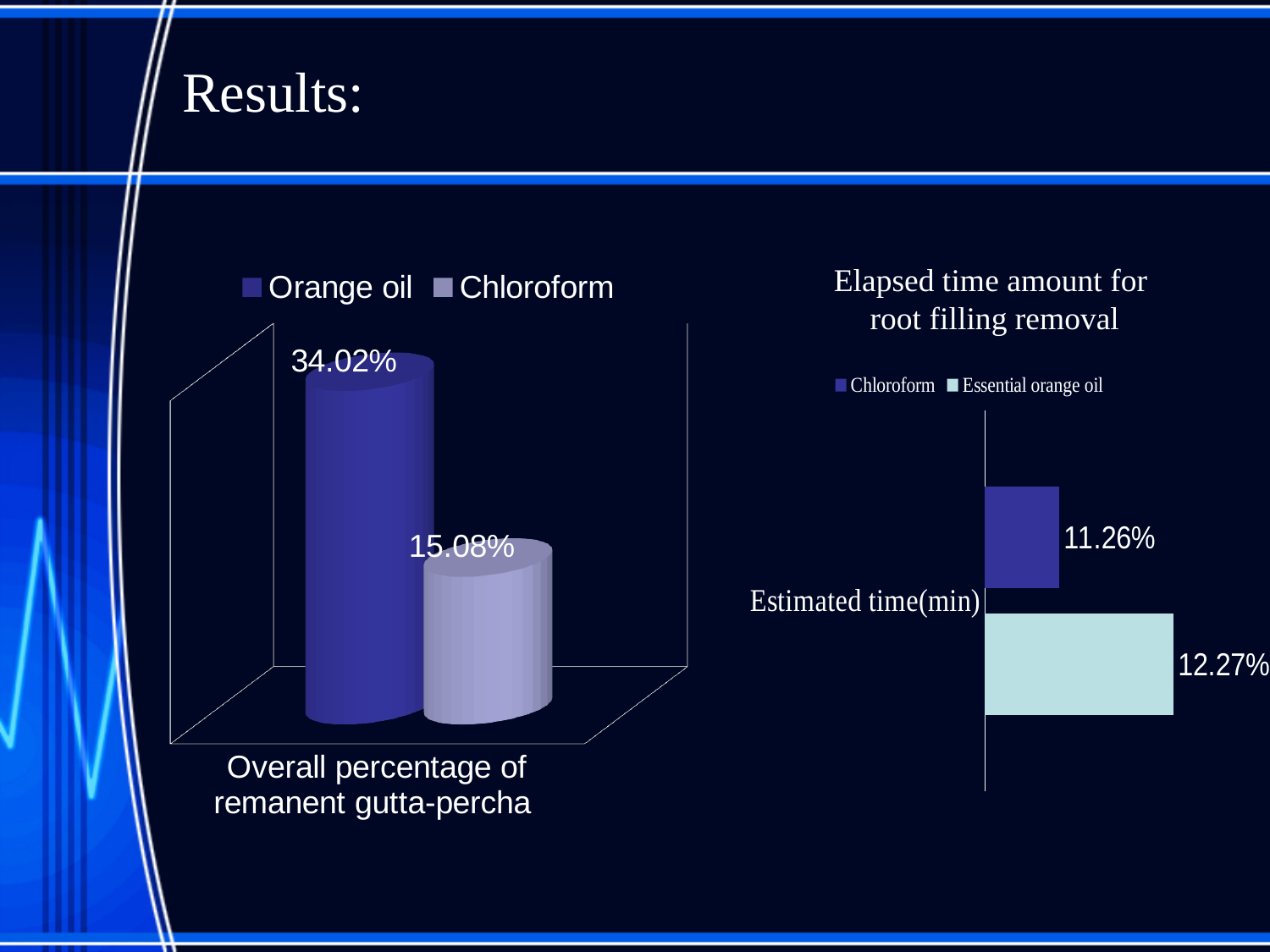
In the left chart, which series has the higher value, Orange oil or Chloroform? Orange oil What kind of chart is the chart titled 'Elapsed time amount for root filling removal'? Bar chart What is the category label shown on the left chart? Overall percentage of remanent gutta-percha In the chart titled 'Elapsed time amount for root filling removal', what is the value for Chloroform? 11.26% In the left chart, what is the value for Orange oil? 34.02% What is the category label on the axis of the chart titled 'Elapsed time amount for root filling removal'? Estimated time(min) In the left chart, what is the difference between the Orange oil and Chloroform values? 18.94% In the left chart, what is the value for Chloroform? 15.08% How many series does the legend of the left chart list? 2 In the chart titled 'Elapsed time amount for root filling removal', which series has the larger value, Chloroform or Essential orange oil? Essential orange oil In the chart titled 'Elapsed time amount for root filling removal', what is the value for Essential orange oil? 12.27% In the chart titled 'Elapsed time amount for root filling removal', what is the difference between the Essential orange oil and Chloroform values? 1.01%